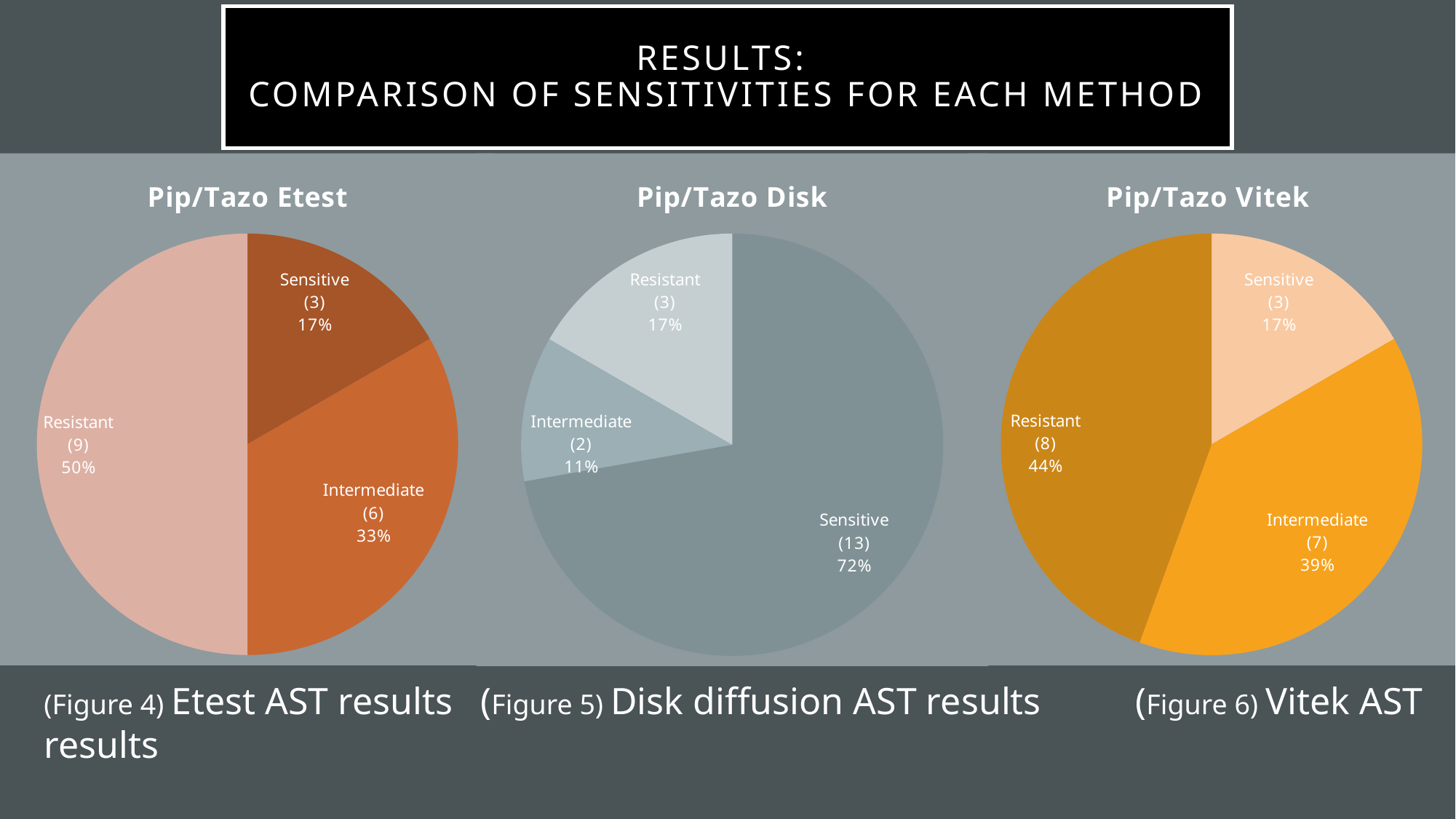
In the Pip/Tazo Vitek chart, which category has the largest slice? Resistant What is the title of the chart on the right of the slide? Pip/Tazo Vitek In the Pip/Tazo Disk chart, what share of the pie does the Intermediate slice represent? 11% In the Pip/Tazo Etest chart, what is the difference in count between Resistant and Intermediate isolates? 3 In the Pip/Tazo Etest chart, which category has the smallest slice? Sensitive In the Pip/Tazo Disk chart, how many isolates were Sensitive? 13 What kind of chart is the Pip/Tazo Disk chart? Pie chart In the Pip/Tazo Disk chart, which is larger, the Resistant slice or the Intermediate slice? Resistant In the Pip/Tazo Disk chart, which category has the largest slice? Sensitive In the Pip/Tazo Vitek chart, what percentage of isolates were Intermediate? 39% How many categories does the Pip/Tazo Vitek chart show? 3 In the Pip/Tazo Etest chart, what percentage of isolates were Resistant? 50%